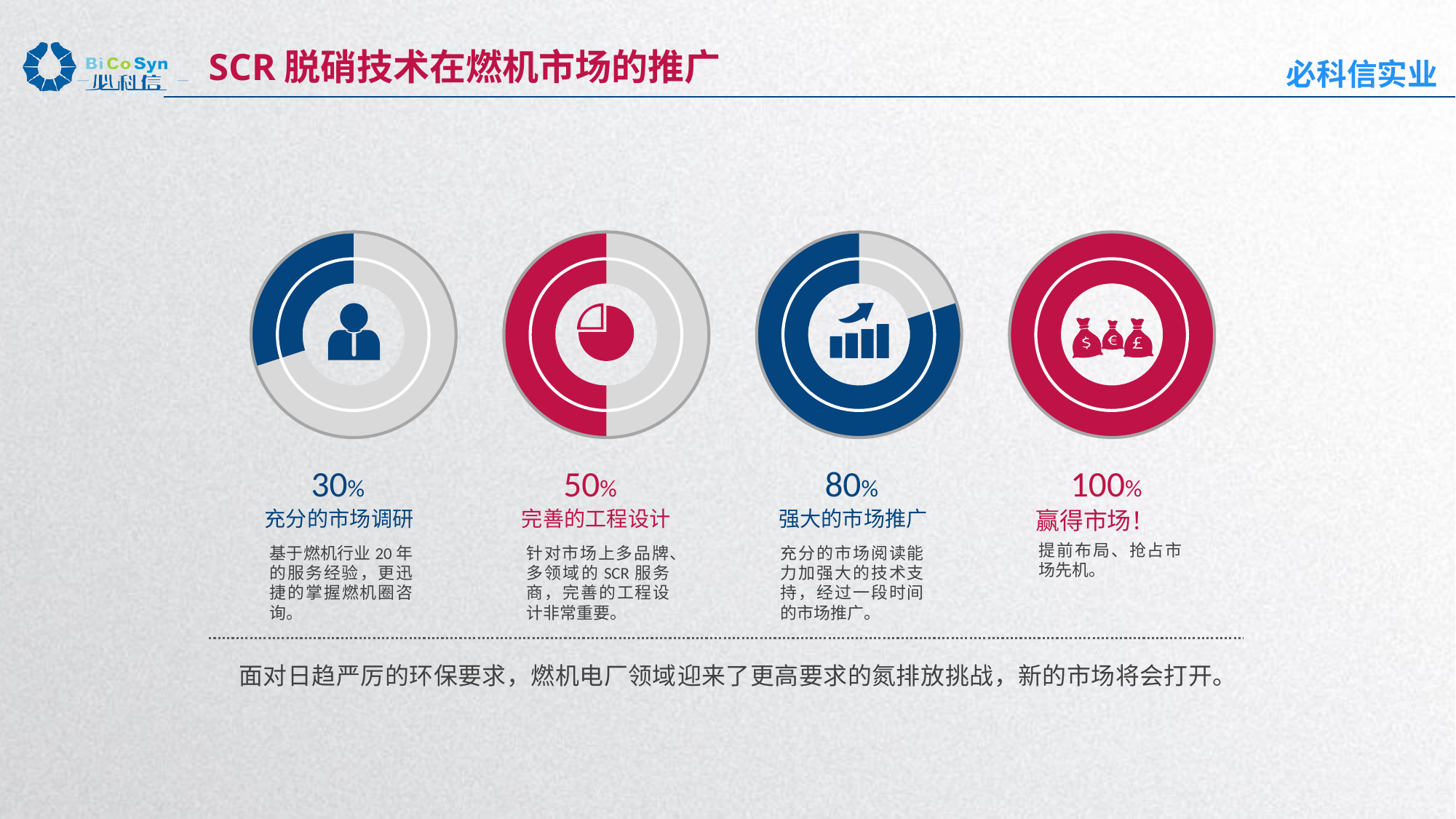
Do the percentages rise or fall going from the leftmost ring chart to the rightmost? Rise What is the difference between the percentage for 强大的市场推广 and the percentage for 充分的市场调研? 50% How many ring charts are shown on the slide? 4 What percentage is shown for 赢得市场! (the rightmost ring chart)? 100% What percentage is shown for 强大的市场推广 (the third ring chart from the left)? 80% What colour is the filled portion of the ring chart for 完善的工程设计? Red Which of the four ring charts shows the lowest percentage? 充分的市场调研 Which is larger, the percentage for 完善的工程设计 or the percentage for 强大的市场推广? 强大的市场推广 What percentage is shown for 完善的工程设计 (the second ring chart from the left)? 50% What percentage is shown for 充分的市场调研 (the first ring chart from the left)? 30% Which of the four ring charts shows the highest percentage? 赢得市场! What kind of chart is used to show the four percentages on the slide? Donut (ring) chart